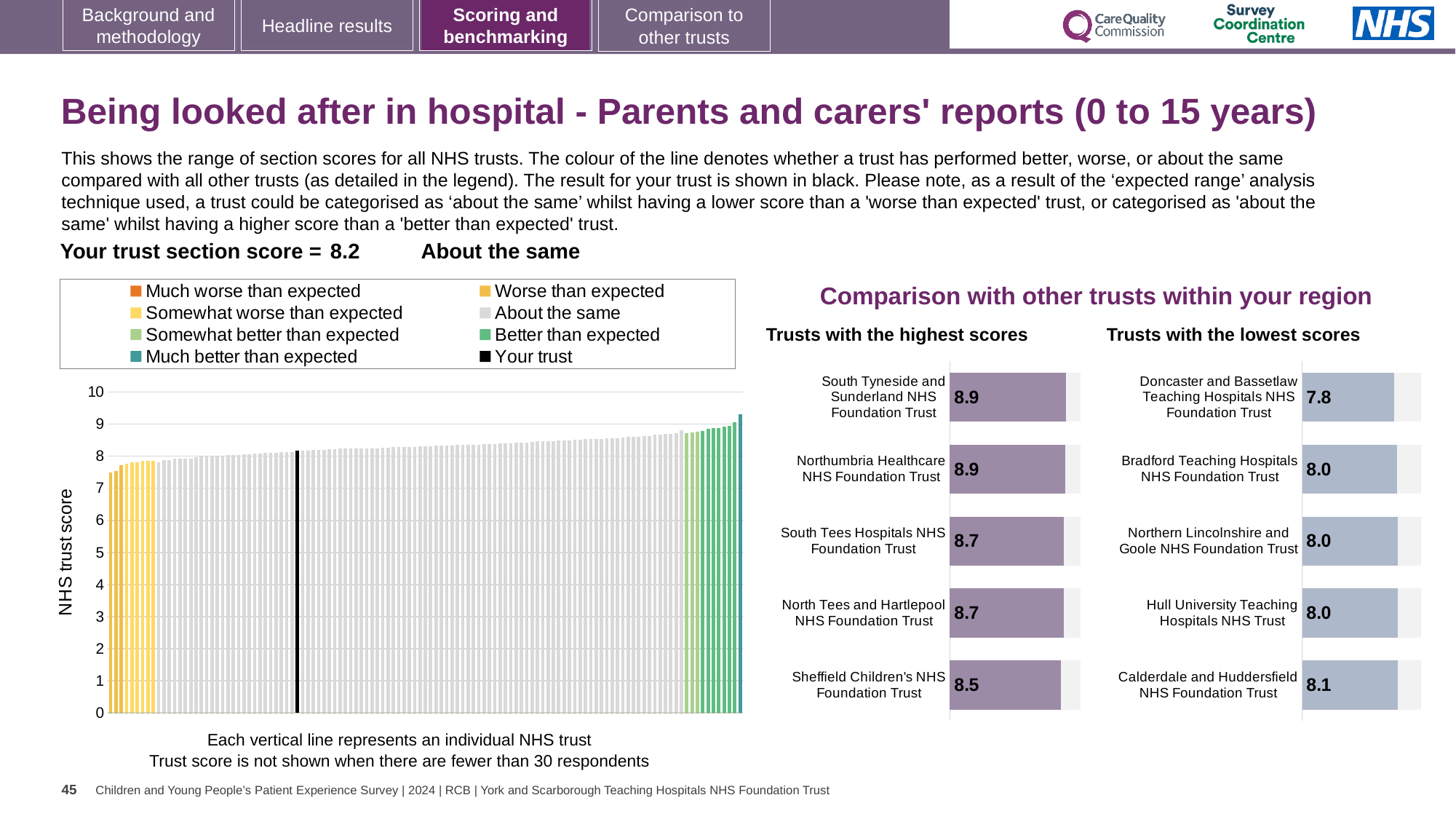
How many trusts are listed in the 'Trusts with the highest scores' chart? 5 In the 'Trusts with the lowest scores' chart, which trust has the lowest score? Doncaster and Bassetlaw Teaching Hospitals NHS Foundation Trust In the 'Trusts with the lowest scores' chart, how much higher is Calderdale and Huddersfield NHS Foundation Trust's score than Doncaster and Bassetlaw Teaching Hospitals NHS Foundation Trust's score? 0.3 In the 'Trusts with the highest scores' chart, which has the higher score: South Tees Hospitals NHS Foundation Trust or Sheffield Children's NHS Foundation Trust? South Tees Hospitals NHS Foundation Trust In the 'Trusts with the lowest scores' chart, what is the score for Doncaster and Bassetlaw Teaching Hospitals NHS Foundation Trust? 7.8 What is the section score for your trust shown on the slide? 8.2 How many entries does the legend above the left-hand NHS trust score chart list? 8 In the 'Trusts with the highest scores' chart, what is the difference between the scores of South Tyneside and Sunderland NHS Foundation Trust and Sheffield Children's NHS Foundation Trust? 0.4 In the 'Trusts with the highest scores' chart, which trust has the lowest score? Sheffield Children's NHS Foundation Trust In the 'Trusts with the lowest scores' chart, what is the score for Calderdale and Huddersfield NHS Foundation Trust? 8.1 In the 'Trusts with the highest scores' chart, what is the score for Sheffield Children's NHS Foundation Trust? 8.5 What kind of chart is the large chart on the left showing NHS trust scores? Bar chart